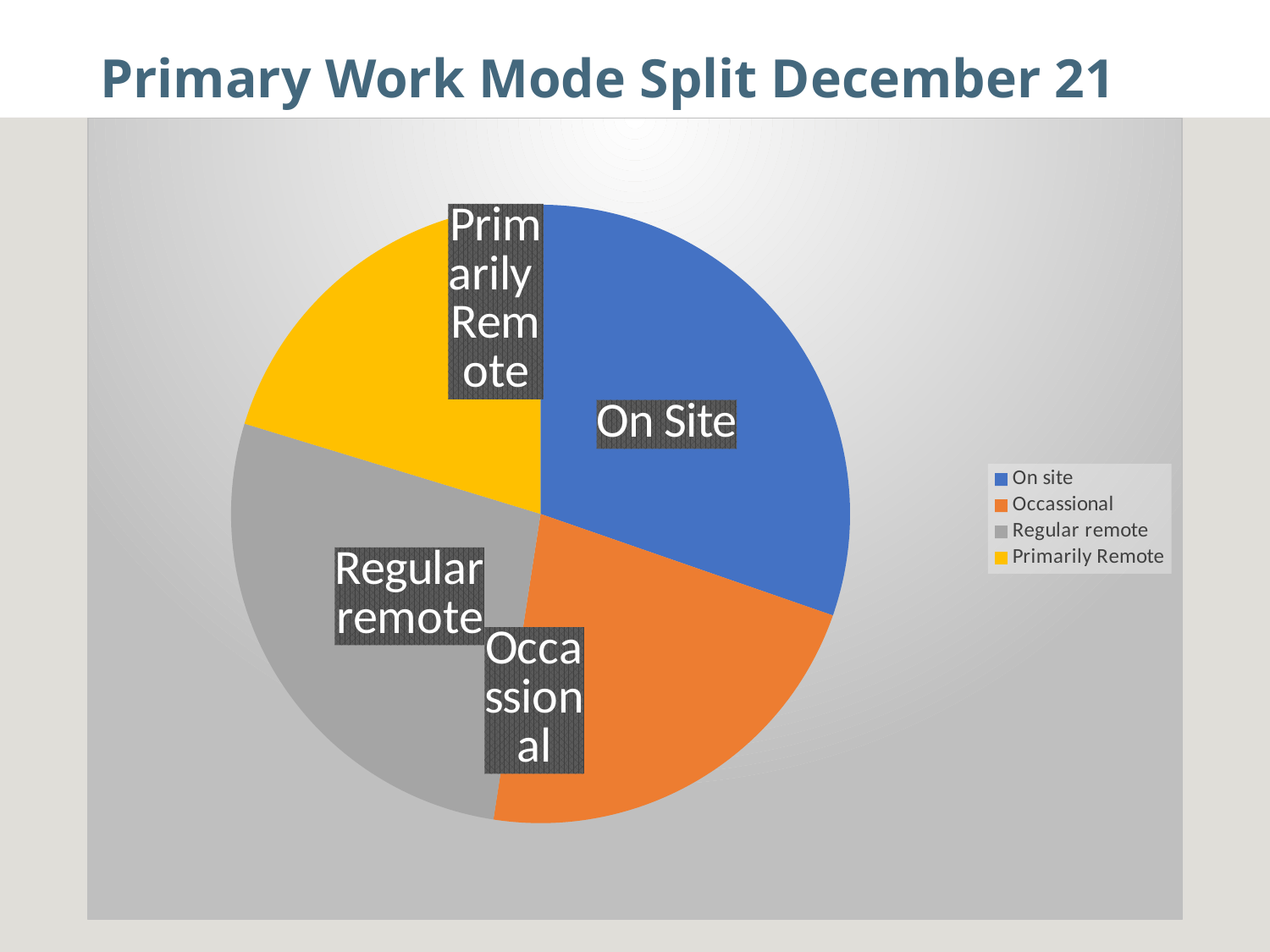
Which slice is larger, Regular remote or Primarily Remote? Regular remote How many entries does the legend list? 4 What kind of chart is shown on the slide? pie chart What is the title of the slide? Primary Work Mode Split December 21 Which slice is larger, On Site or Primarily Remote? On Site Which slice is larger, On Site or Occassional? On Site Which colour represents Regular remote in the pie chart? grey How many slices does the pie chart have? 4